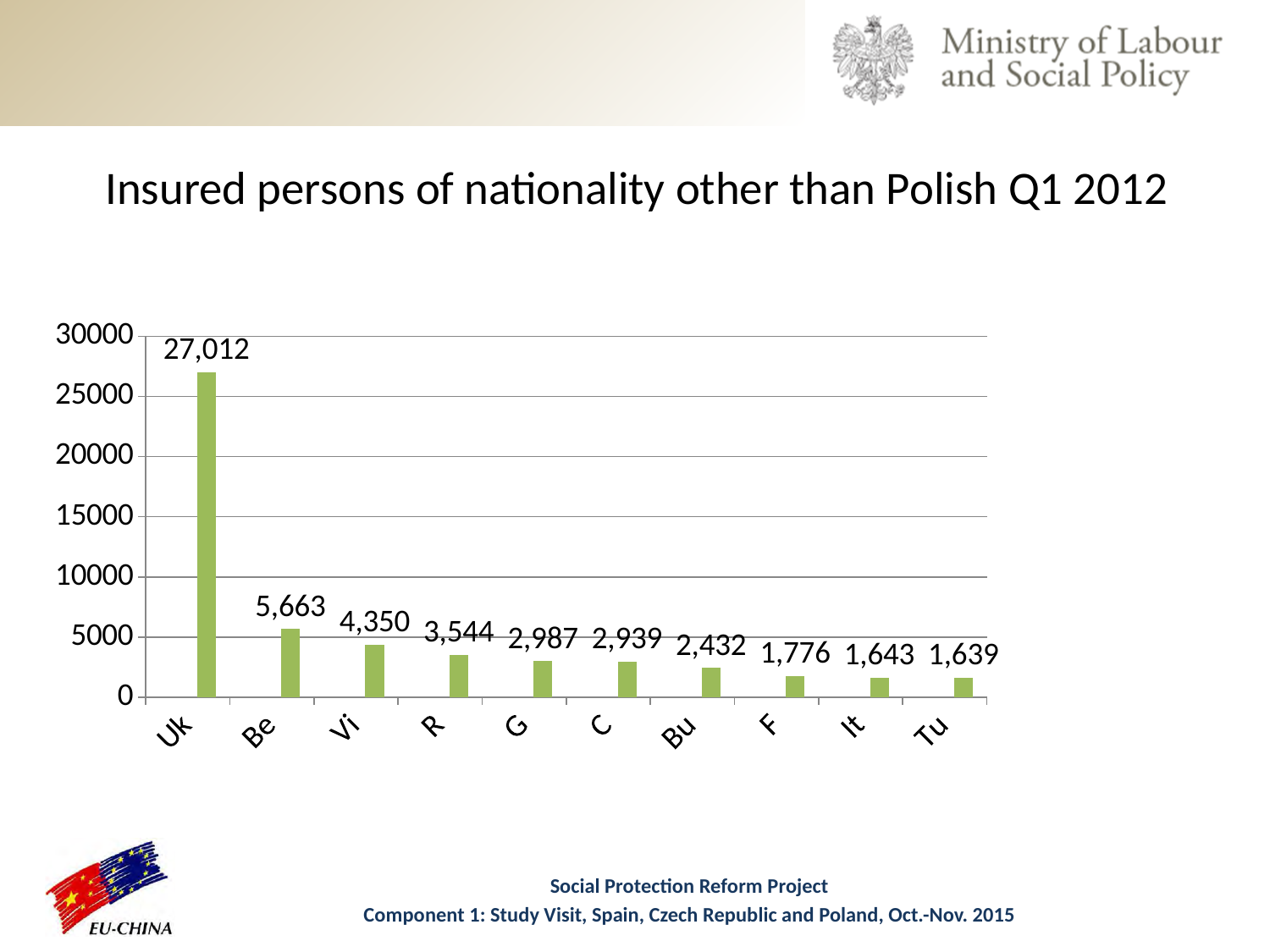
What is the value for Be? 5,663 What is the value for Bu? 2,432 Is the value for Uk greater or less than 25000? greater Which category has the highest value? Uk What is the value for Tu? 1,639 What is the difference between the values for Vi and R? 806 What is the value for Uk? 27,012 What is the title of the chart? Insured persons of nationality other than Polish Q1 2012 Which is larger, the value for G or the value for C? G How many categories are shown on the x axis? 10 What is the difference between the values for Uk and Be? 21,349 What kind of chart is shown on the slide? bar chart